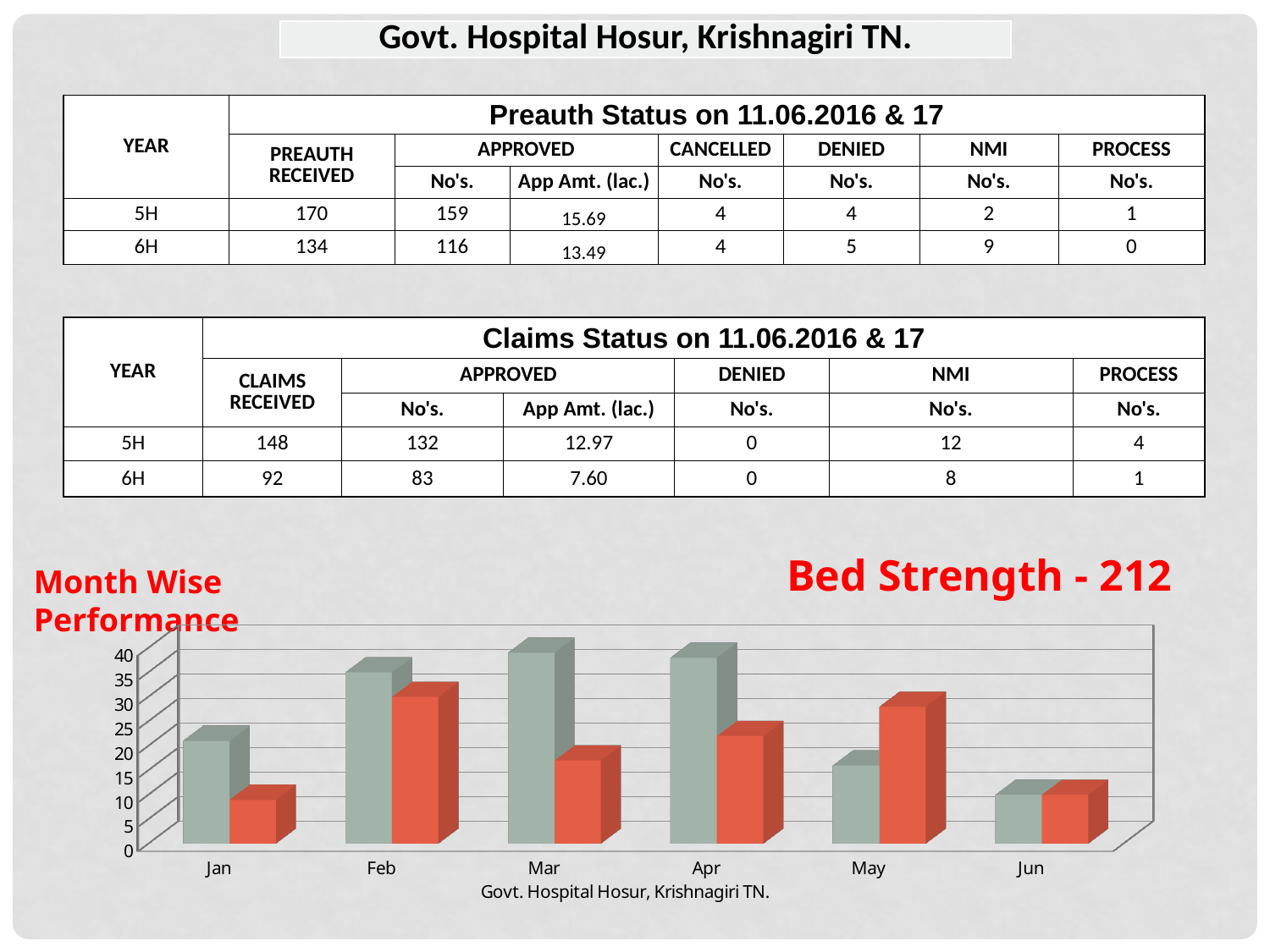
In the bar chart, is the grey bar for Feb greater or less than 30? greater In the bar chart, do the grey bars rise or fall from Apr to Jun? Fall In the bar chart, which month has the lowest grey bar? Jun In the bar chart, is the orange bar for Jan greater or less than 15? less What kind of chart is shown at the bottom of the slide? Bar chart In the bar chart, is the orange bar for May greater or less than 25? greater In the bar chart, which is larger for May, the grey bar or the orange bar? The orange bar In the bar chart, which is larger for Mar, the grey bar or the orange bar? The grey bar What title is printed beneath the bar chart's x axis? Govt. Hospital Hosur, Krishnagiri TN. How many months are shown on the x axis of the bar chart? 6